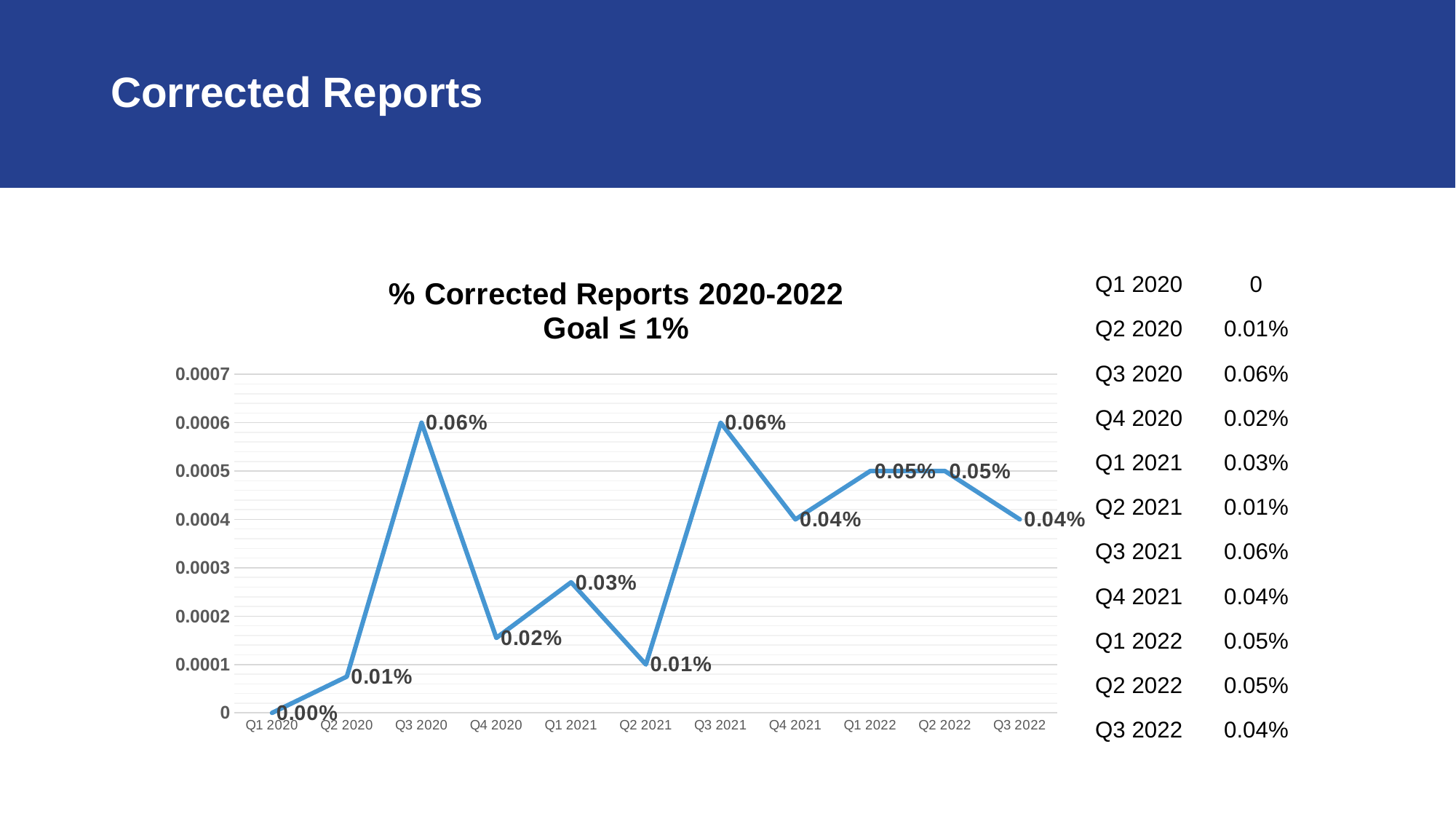
How many quarters are plotted on the chart? 11 What is the title of the chart? % Corrected Reports 2020-2022 Goal ≤ 1% What is the value for Q3 2020? 0.06% What is the value for Q1 2021? 0.03% What is the value for Q4 2021? 0.04% What is the difference between the values for Q3 2020 and Q4 2020? 0.04% What is the difference between the values for Q1 2022 and Q3 2022? 0.01% What type of chart is shown on the slide? line chart Does the value rise or fall from Q2 2022 to Q3 2022? fall Which quarter has the lowest value? Q1 2020 Which is larger, the value for Q1 2021 or the value for Q2 2021? Q1 2021 Is the value for Q3 2021 greater or less than 0.0005 on the y axis? greater